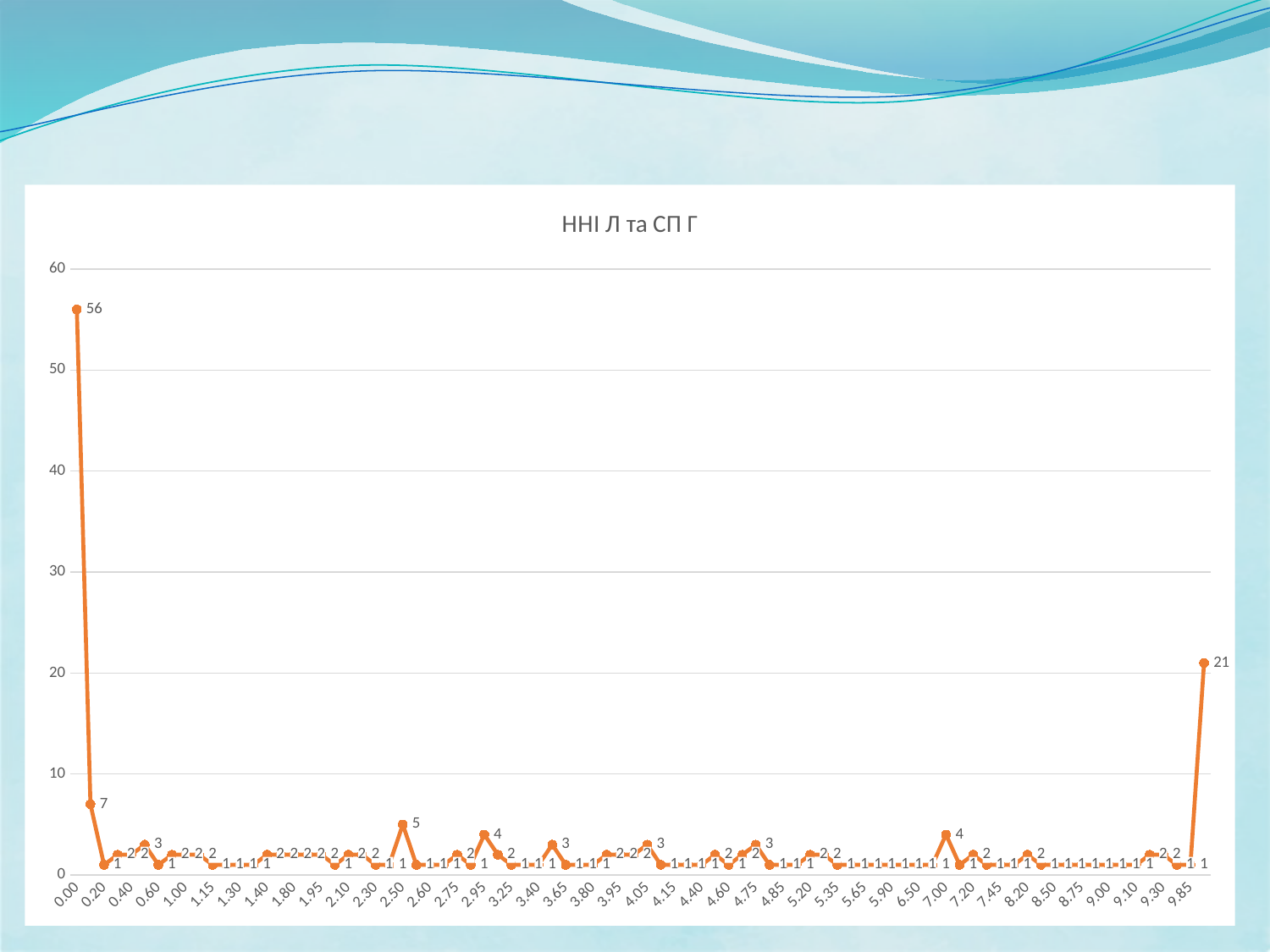
What is the value at 2.50? 5 Does the line rise or fall between the first point at 0.00 and the second point? fall Which x-axis category has the highest value? 0.00 What is the value of the first data point, at 0.00? 56 Is the value at 0.00 greater or less than 50? greater What is the difference between the first data point (56) and the last data point (21)? 35 What is the highest value shown on the y-axis? 60 What is the value at 7.00? 4 Which is larger, the value at 2.50 or the value at 7.00? 2.50 What is the title of the chart? ННІ Л та СП Г What is the value of the last data point on the right end of the line? 21 What kind of chart is shown on the slide? line chart